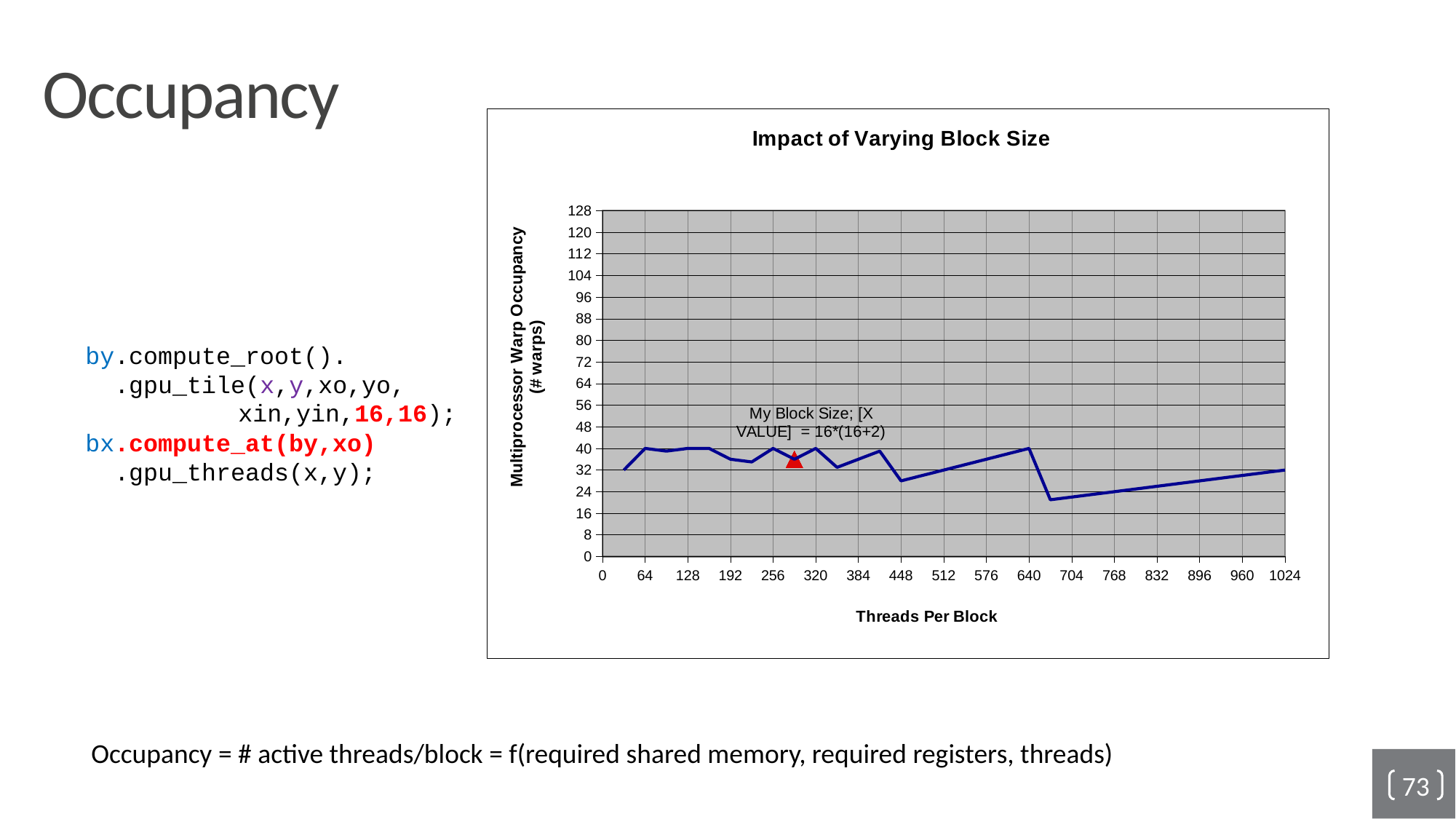
What is the Multiprocessor Warp Occupancy at 64 Threads Per Block? 40 What is the Multiprocessor Warp Occupancy at 1024 Threads Per Block? 32 What is the label of the x axis of the chart? Threads Per Block Which has the higher Multiprocessor Warp Occupancy: 64 Threads Per Block or 448 Threads Per Block? 64 What is the title of the chart? Impact of Varying Block Size What is the Multiprocessor Warp Occupancy at 640 Threads Per Block? 40 What kind of chart is shown on the slide? line chart Which has the higher Multiprocessor Warp Occupancy: 640 Threads Per Block or 1024 Threads Per Block? 640 Between which two x-axis ticks does the line reach its lowest value? 640 and 704 Does the Multiprocessor Warp Occupancy rise or fall as Threads Per Block increases from 704 to 1024? rise Is the Multiprocessor Warp Occupancy at 1024 Threads Per Block greater or less than 24? greater Is the Multiprocessor Warp Occupancy at 448 Threads Per Block greater or less than 32? less